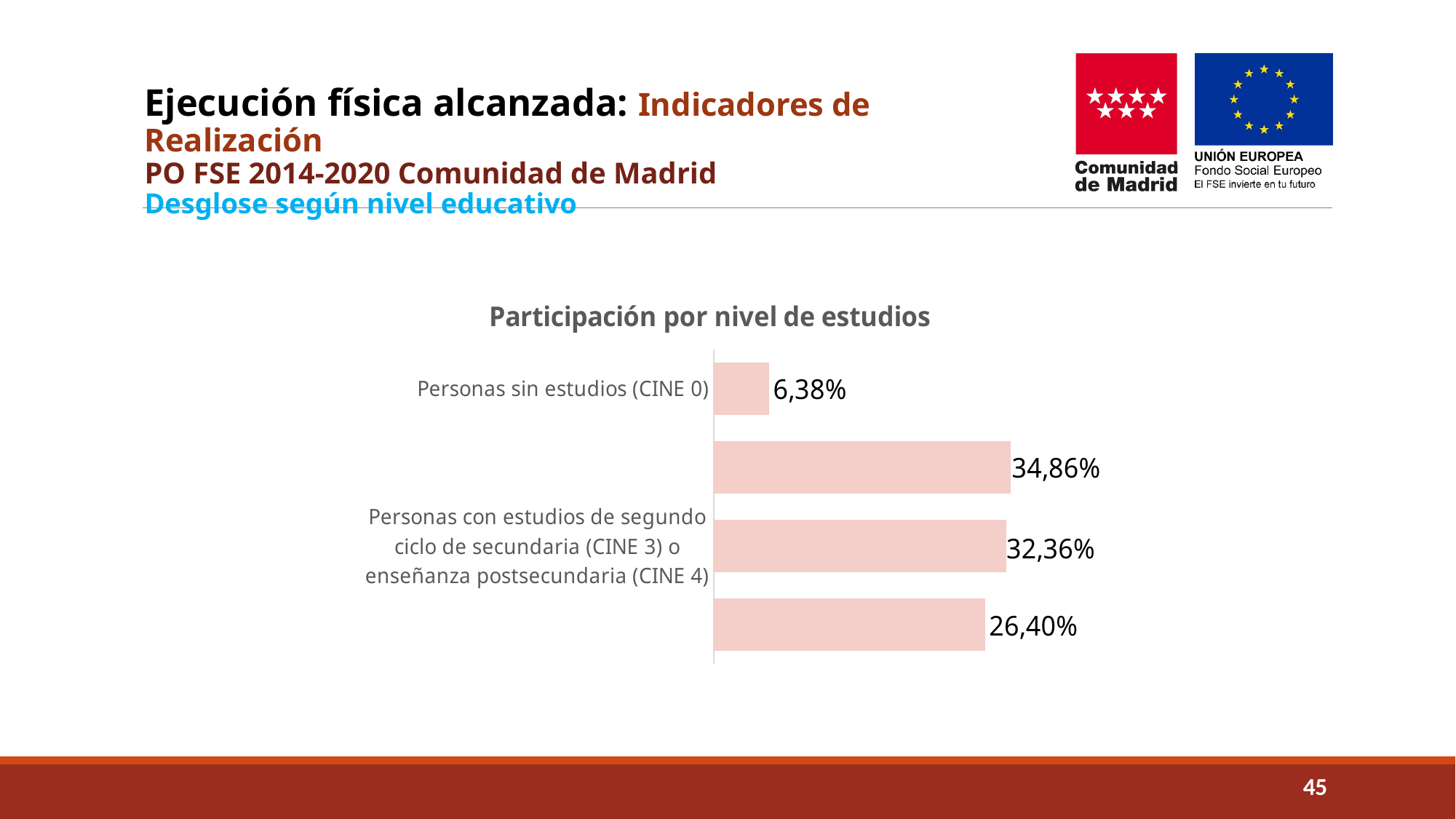
What is the value for Personas con estudios de segundo ciclo de secundaria (CINE 3) o enseñanza postsecundaria (CINE 4)? 32,36% What is the highest value shown in the chart? 34,86% What is the value for Personas sin estudios (CINE 0)? 6,38% What is the value shown on the second bar from the top? 34,86% Which is larger: the value for Personas sin estudios (CINE 0) or the value for Personas con estudios de segundo ciclo de secundaria (CINE 3) o enseñanza postsecundaria (CINE 4)? Personas con estudios de segundo ciclo de secundaria (CINE 3) o enseñanza postsecundaria (CINE 4) How many bars are plotted in the chart? 4 Which category has the lowest value? Personas sin estudios (CINE 0) What is the title of the chart? Participación por nivel de estudios What is the difference between the value for Personas con estudios de segundo ciclo de secundaria (CINE 3) o enseñanza postsecundaria (CINE 4) and the value for Personas sin estudios (CINE 0)? 25,98% What is the difference between the highest value (34,86%) and the lowest value (6,38%) in the chart? 28,48% What is the value shown on the bottom bar of the chart? 26,40% What kind of chart is shown on the slide? Bar chart